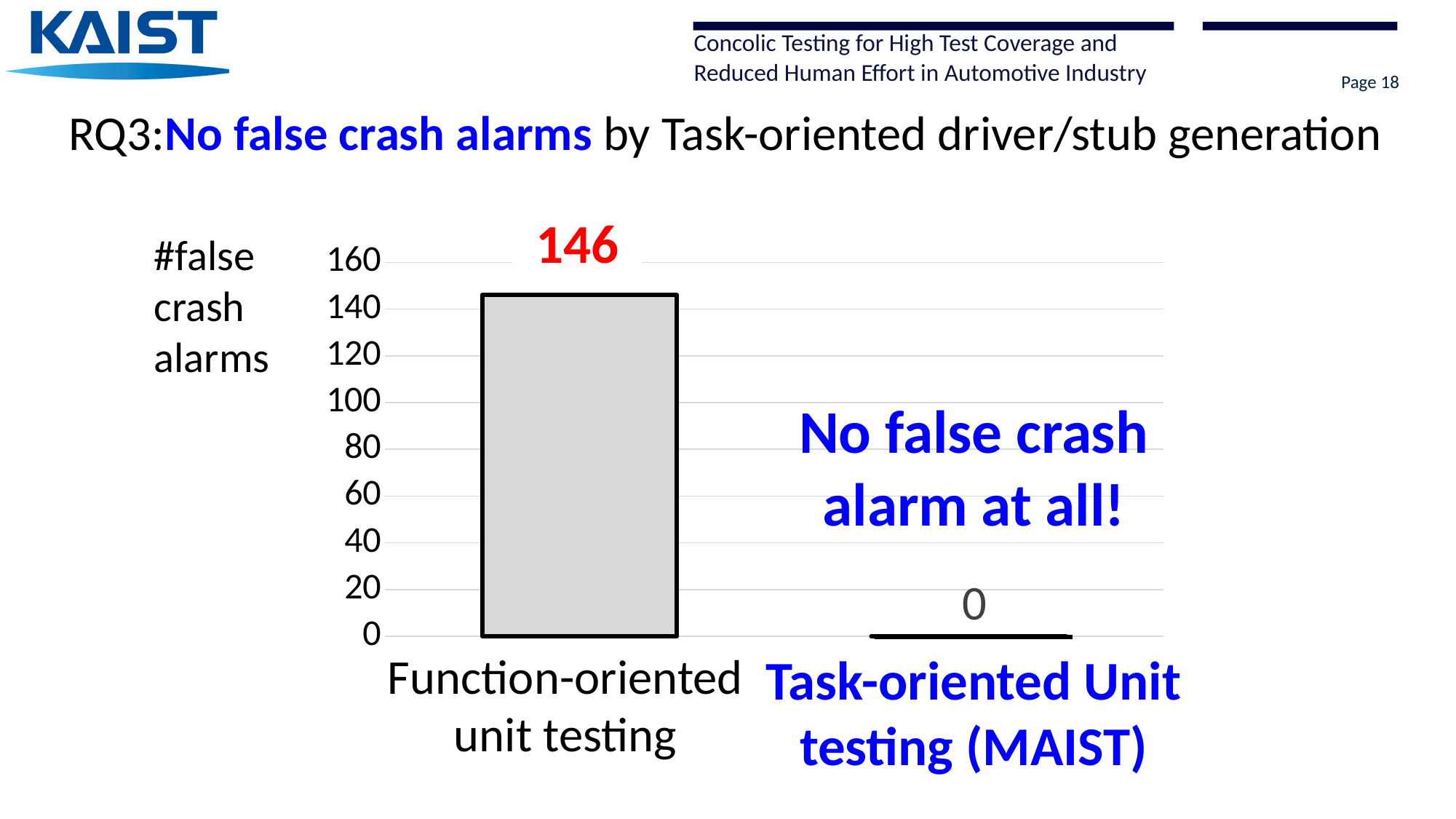
Which category has the highest number of false crash alarms? Function-oriented unit testing Is the value for Function-oriented unit testing greater or less than 140? greater What is the number of false crash alarms for Function-oriented unit testing? 146 What is the number of false crash alarms for Task-oriented Unit testing (MAIST)? 0 What kind of chart is shown on the slide? bar chart Which category has the lowest number of false crash alarms? Task-oriented Unit testing (MAIST) What is the maximum value shown on the y axis of the chart? 160 What does the y axis of the chart measure? #false crash alarms How many categories are shown on the x axis of the chart? 2 What is the difference in false crash alarms between Function-oriented unit testing and Task-oriented Unit testing (MAIST)? 146 Which has more false crash alarms, Function-oriented unit testing or Task-oriented Unit testing (MAIST)? Function-oriented unit testing